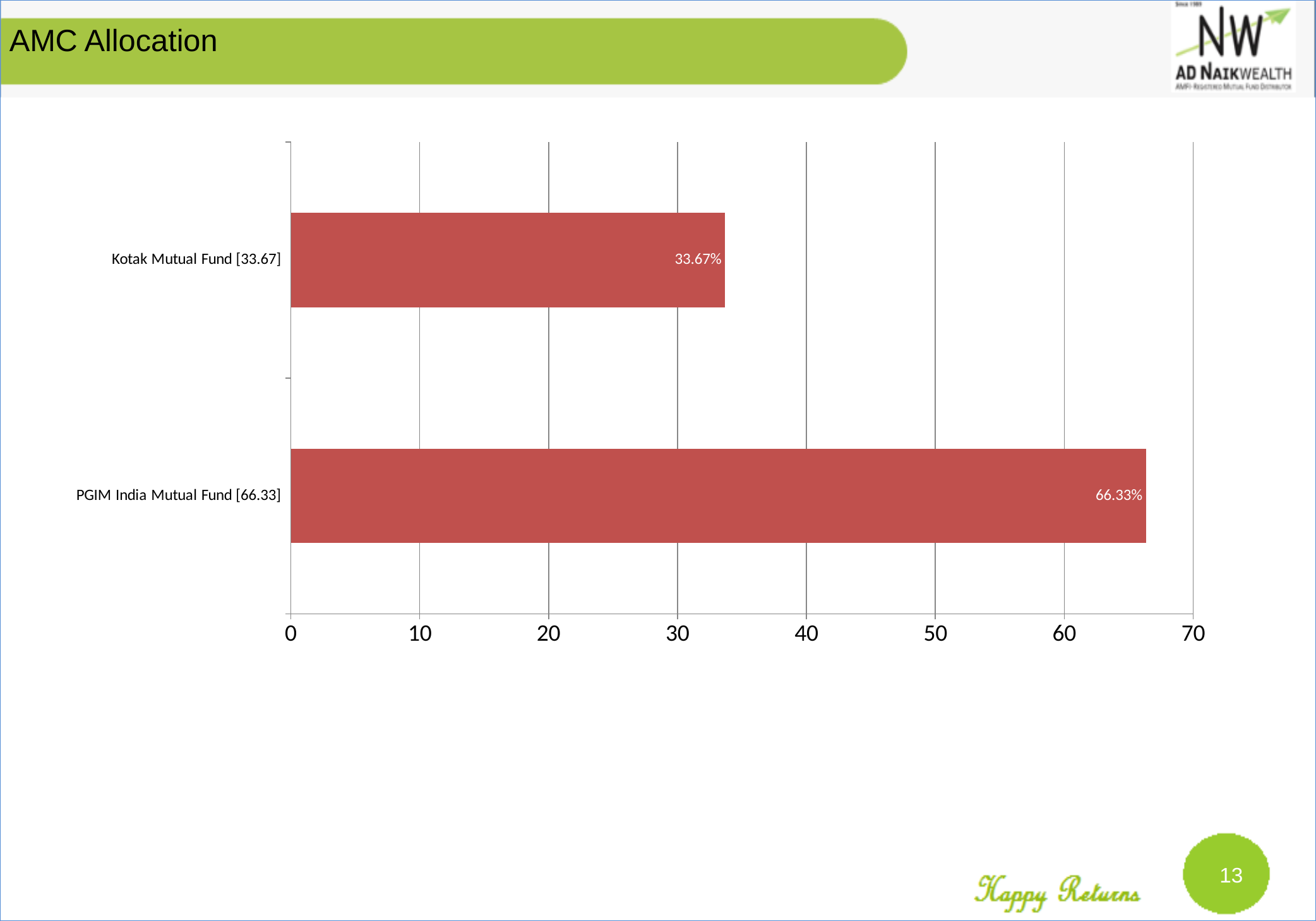
What kind of chart is shown on the slide? bar chart Which AMC has the lowest allocation? Kotak Mutual Fund Is the value for PGIM India Mutual Fund greater or less than 60? greater How many categories are shown in the chart? 2 What is the value for PGIM India Mutual Fund? 66.33% What is the total of the two values shown in the chart? 100% Which AMC has the highest allocation? PGIM India Mutual Fund What is the value for Kotak Mutual Fund? 33.67% Which is larger, the value for Kotak Mutual Fund or PGIM India Mutual Fund? PGIM India Mutual Fund What is the title of the slide? AMC Allocation Is the value for Kotak Mutual Fund greater or less than 40? less What is the difference between the PGIM India Mutual Fund and Kotak Mutual Fund values? 32.66%